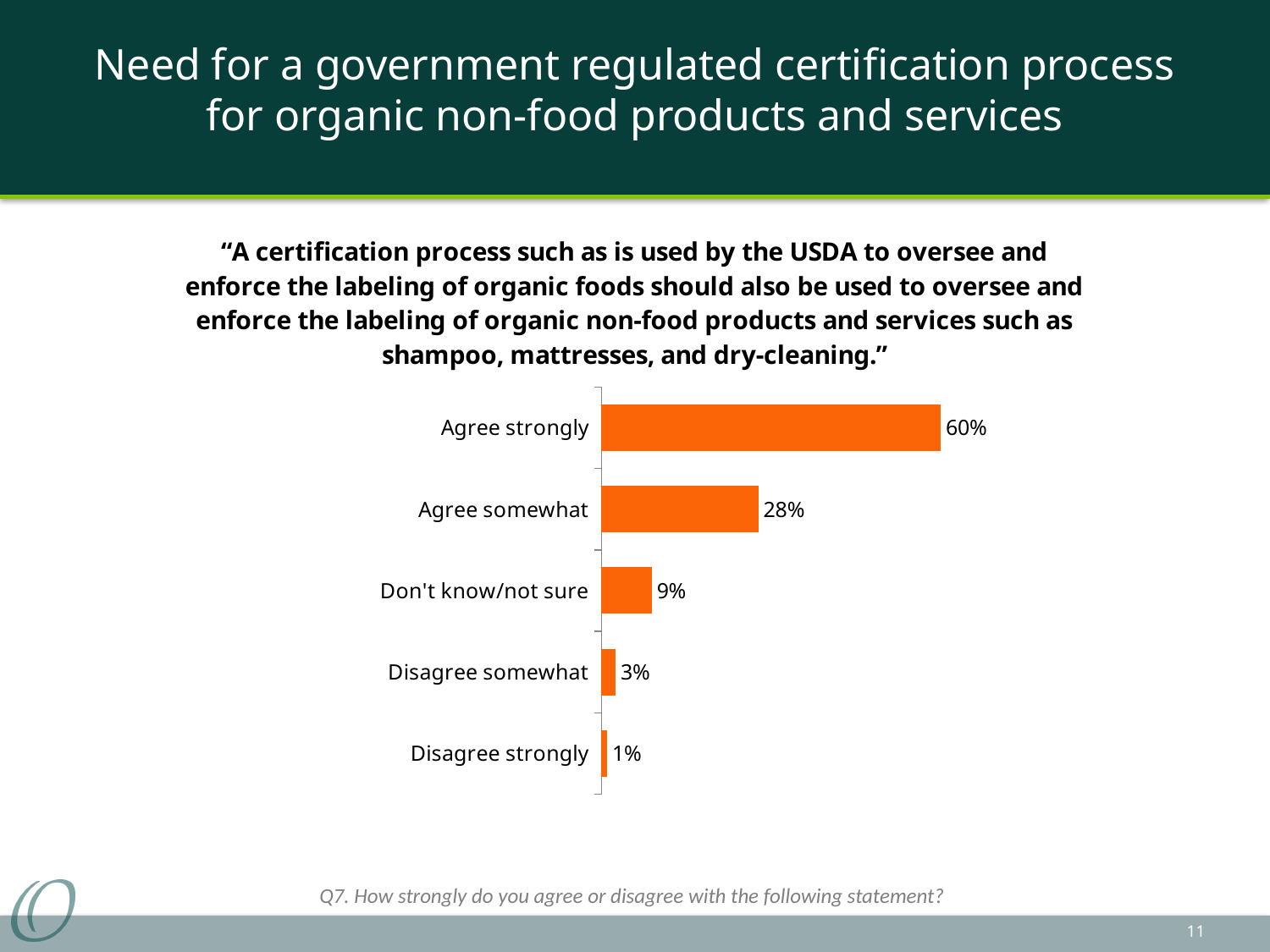
What is the difference between "Don't know/not sure" and "Disagree somewhat"? 6 percentage points What is the value for "Agree somewhat"? 28% What type of chart is shown on the slide? Bar chart What is the difference between "Agree strongly" and "Agree somewhat"? 32 percentage points What is the value for "Disagree strongly"? 1% Which response category has the highest value? Agree strongly What colour are the bars in the chart? Orange What percentage of respondents chose "Agree strongly"? 60% How many response categories are shown in the chart? 5 Which response category has the lowest value? Disagree strongly Which is larger, the value for "Agree somewhat" or the value for "Don't know/not sure"? Agree somewhat What percentage of respondents answered "Don't know/not sure"? 9%